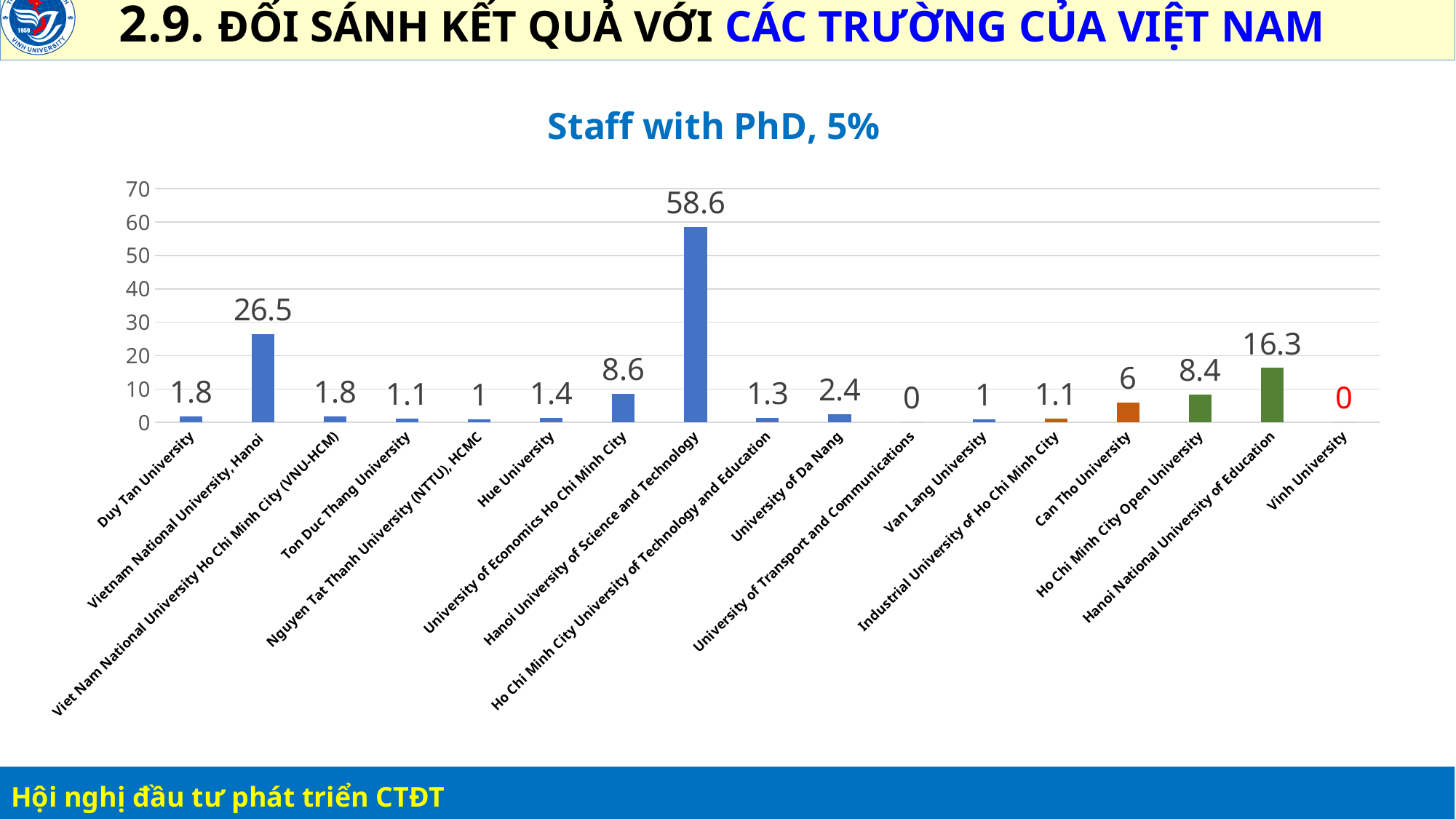
What is the value for Vinh University? 0 What kind of chart is shown on the slide? bar chart What is the title of the chart? Staff with PhD, 5% What is the value for Hanoi National University of Education? 16.3 Which university has the highest value? Hanoi University of Science and Technology How many universities are shown on the x axis? 17 Is the value for Hanoi University of Science and Technology greater or less than 50? greater What is the value for Vietnam National University, Hanoi? 26.5 Which is larger, the value for University of Economics Ho Chi Minh City or the value for Ho Chi Minh City Open University? University of Economics Ho Chi Minh City What is the value for Hanoi University of Science and Technology? 58.6 What is the value for Can Tho University? 6 What is the difference between the values for Hanoi University of Science and Technology and Vietnam National University, Hanoi? 32.1